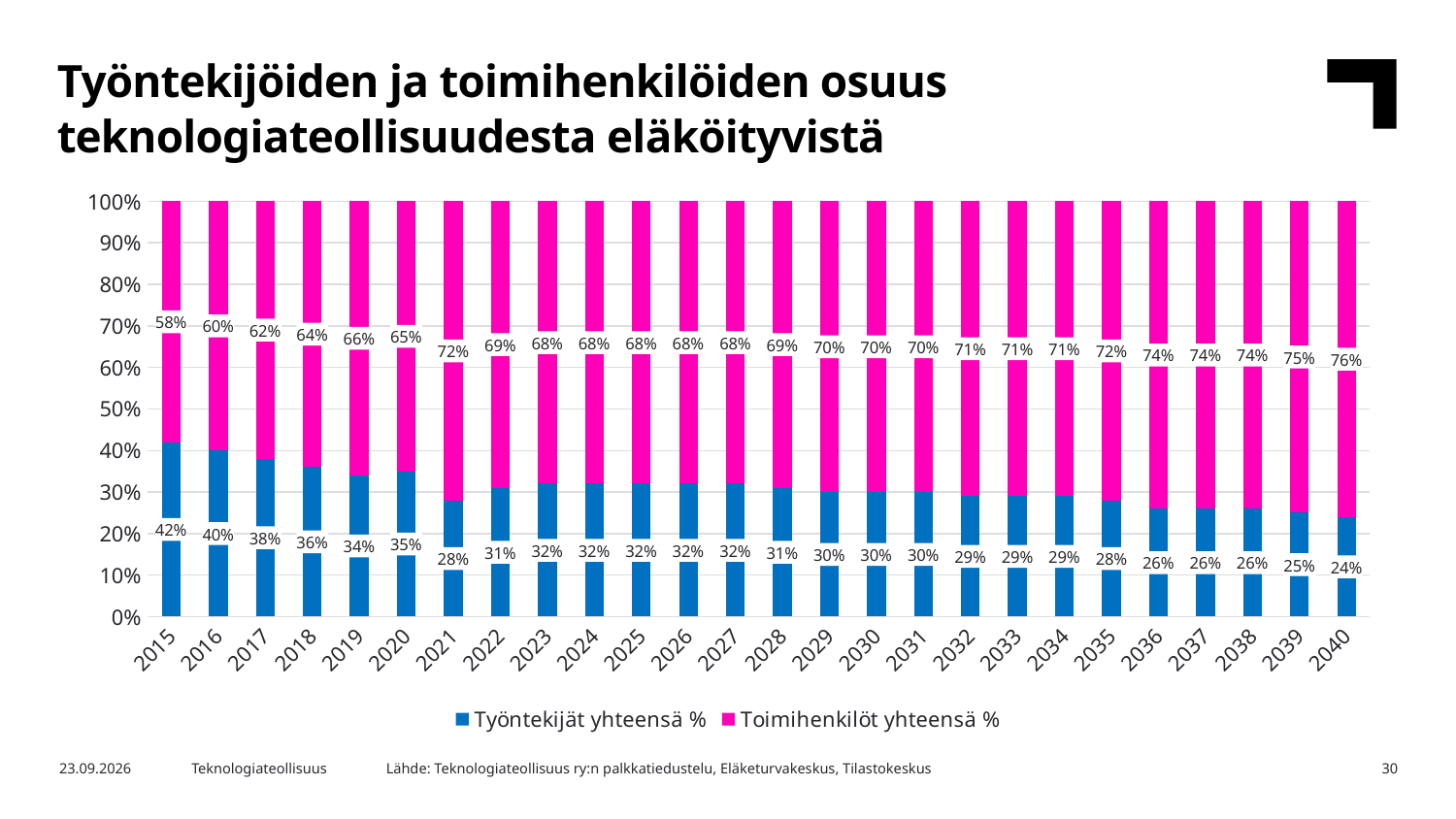
What is the value for Työntekijät yhteensä % in 2015? 42% Does the Toimihenkilöt yhteensä % share generally rise or fall from 2015 to 2040? Rise Which is larger in 2019: Työntekijät yhteensä % or Toimihenkilöt yhteensä %? Toimihenkilöt yhteensä % What kind of chart is shown on the slide? Stacked bar chart What is the value for Toimihenkilöt yhteensä % in 2040? 76% How many series does the legend list? 2 In which year is the Työntekijät yhteensä % share lowest? 2040 How many years are shown on the x axis? 26 In which year is the Työntekijät yhteensä % share highest? 2015 What is the total of the stacked bar for 2030? 100% What is the value for Työntekijät yhteensä % in 2021? 28% What is the difference between the Toimihenkilöt yhteensä % values for 2040 and 2015? 18 percentage points